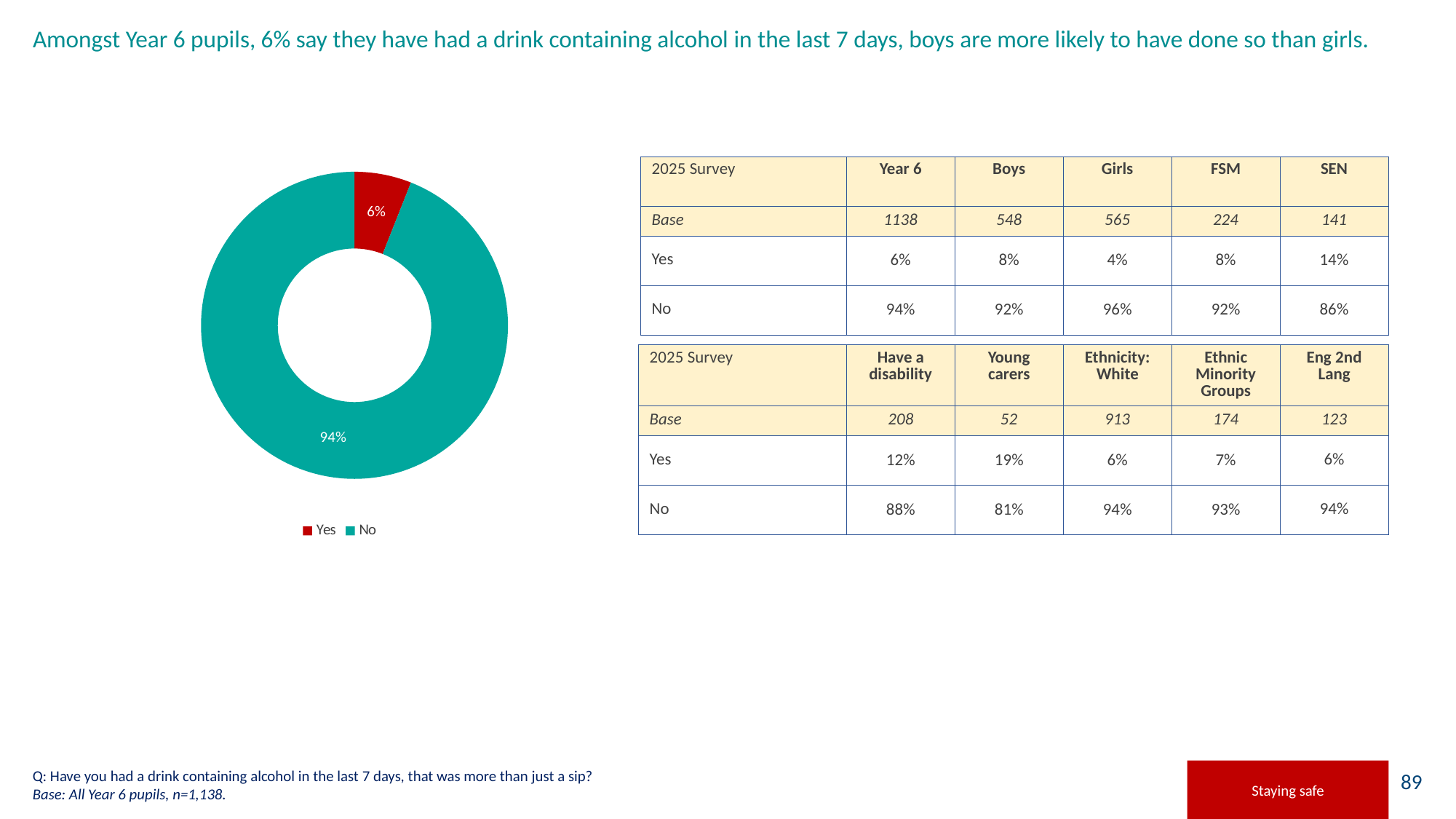
Which slice of the donut chart is the largest? No Which is larger in the donut chart, the "Yes" slice or the "No" slice? No Which slice of the donut chart is the smallest? Yes What colour is the "No" slice in the donut chart? Teal What kind of chart is shown on the slide? Donut (pie) chart What is the difference in percentage points between the "No" slice and the "Yes" slice in the donut chart? 88 What percentage of the donut chart is labelled "Yes"? 6% What percentage of the donut chart is labelled "No"? 94% How many entries does the legend of the donut chart list? 2 What share of the donut chart does the "Yes" slice represent? 6% What colour is the "Yes" slice in the donut chart? Red How many slices does the donut chart have? 2